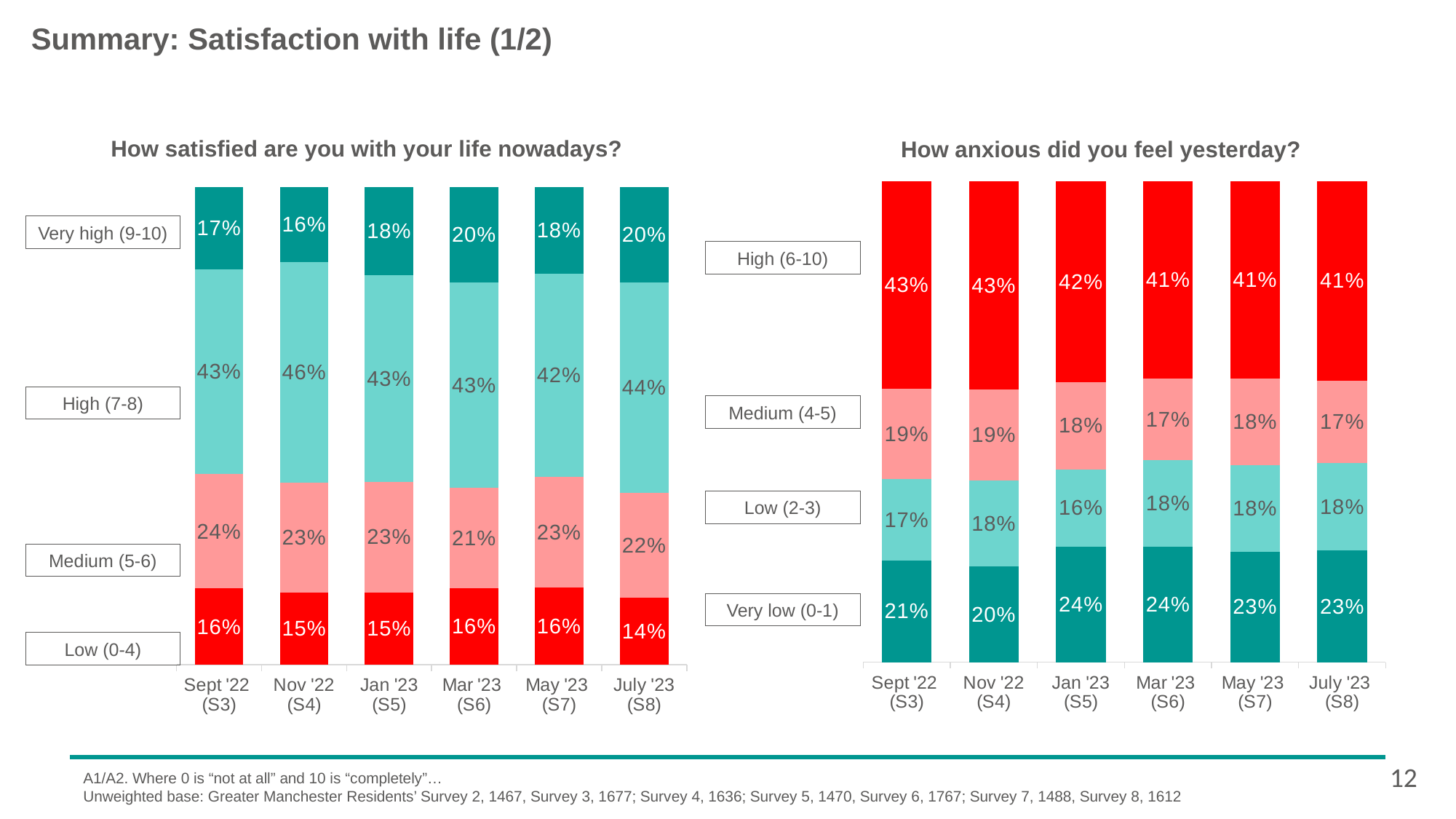
In the chart 'How satisfied are you with your life nowadays?', what percentage gave a Low (0-4) rating in July '23 (S8)? 14% What type of chart is 'How satisfied are you with your life nowadays?'? Stacked bar chart How many survey waves are shown on the x axis of the chart 'How satisfied are you with your life nowadays?'? 6 In the chart 'How anxious did you feel yesterday?', what percentage gave a Very low (0-1) rating in Jan '23 (S5)? 24% In the chart 'How anxious did you feel yesterday?', what percentage gave a High (6-10) rating in Sept '22 (S3)? 43% In the chart 'How satisfied are you with your life nowadays?', what percentage gave a Very high (9-10) rating in Mar '23 (S6)? 20% How many rating bands (series) are stacked in each bar of the chart 'How anxious did you feel yesterday?'? 4 In the chart 'How anxious did you feel yesterday?', which survey wave has the lowest Very low (0-1) percentage? Nov '22 (S4) In the chart 'How anxious did you feel yesterday?', is the High (6-10) percentage larger in Sept '22 (S3) or in July '23 (S8)? Sept '22 (S3) In the chart 'How satisfied are you with your life nowadays?', what is the difference between the Medium (5-6) percentage in Sept '22 (S3) and in Mar '23 (S6)? 3 percentage points In the chart 'How satisfied are you with your life nowadays?', which survey wave has the highest High (7-8) percentage? Nov '22 (S4) In the chart 'How anxious did you feel yesterday?', what colour represents the High (6-10) band? Red